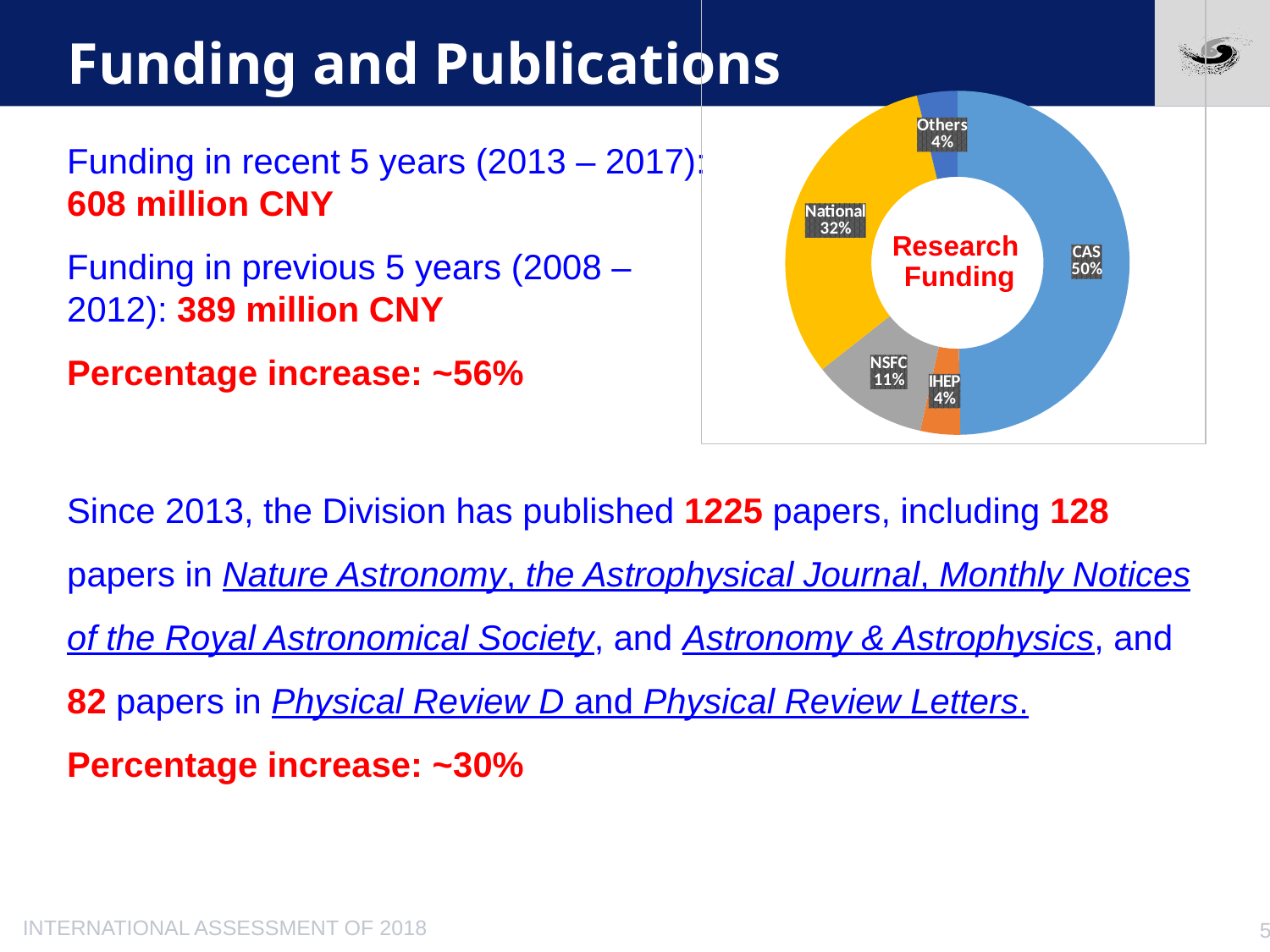
Which is larger, the National share or the NSFC share of Research Funding? National What is the difference between the National share and the NSFC share of Research Funding? 21% What percentage of Research Funding is labelled Others? 4% How many funding sources are shown in the Research Funding chart? 5 What share of Research Funding does CAS account for? 50% How many percentage points larger is the CAS share than the National share? 18% Which funding source has the largest share of Research Funding? CAS What kind of chart is used to show Research Funding? Doughnut (pie) chart What is the NSFC share of Research Funding? 11% What is the title shown in the centre of the chart? Research Funding What percentage of Research Funding is labelled IHEP? 4% What percentage of Research Funding comes from National sources? 32%